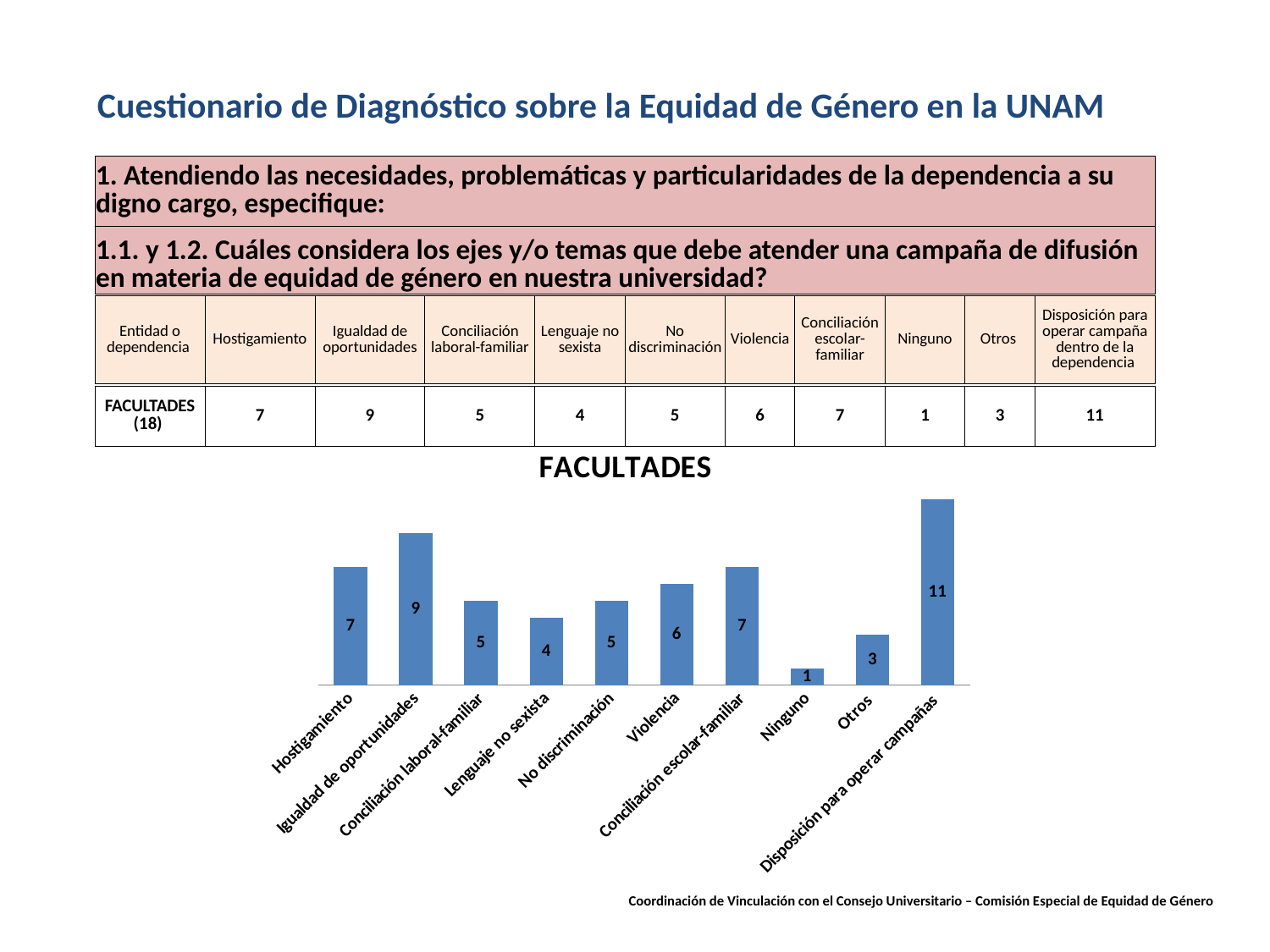
What is the title of the chart on the slide? FACULTADES What is the value for No discriminación in the FACULTADES chart? 5 What is the value for Lenguaje no sexista in the FACULTADES chart? 4 What kind of chart is the FACULTADES chart? Bar chart What is the value for Igualdad de oportunidades in the FACULTADES chart? 9 Which is larger in the FACULTADES chart, Violencia or Otros? Violencia Which category has the lowest value in the FACULTADES chart? Ninguno What is the difference between the values for Conciliación escolar-familiar and Conciliación laboral-familiar in the FACULTADES chart? 2 Which category has the highest value in the FACULTADES chart? Disposición para operar campañas What is the value for Hostigamiento in the FACULTADES chart? 7 How many categories are shown in the FACULTADES chart? 10 What is the difference between the values for Disposición para operar campañas and Igualdad de oportunidades in the FACULTADES chart? 2